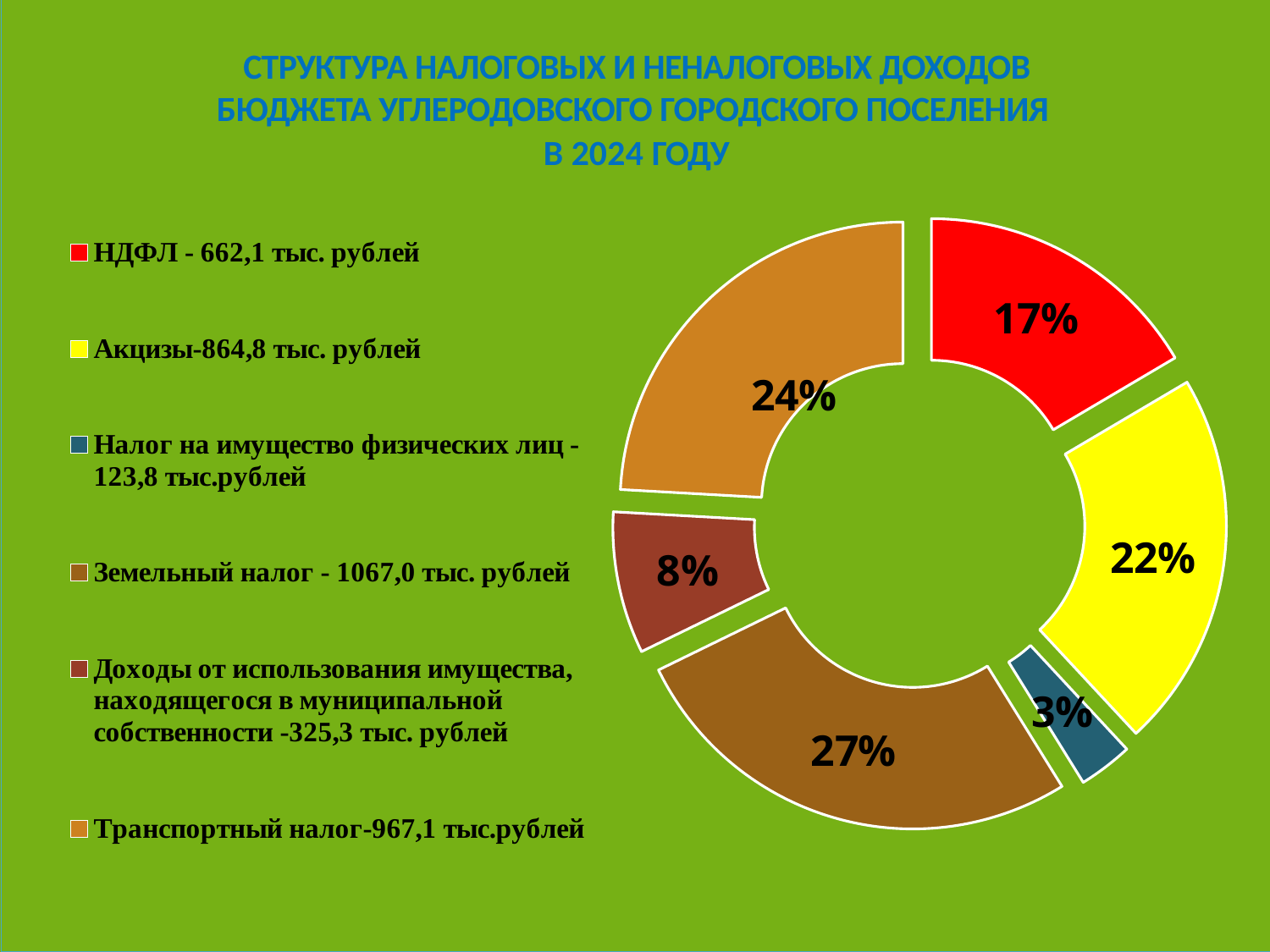
Which category has the smallest share of the chart? Налог на имущество физических лиц According to the legend, what is the value for Земельный налог? 1067,0 тыс. рублей What kind of chart is shown on the slide? Doughnut (pie) chart How many categories does the chart show? 6 What share of the chart does НДФЛ account for? 17% What share of the chart does Акцизы account for? 22% What share of the chart does Земельный налог account for? 27% What colour represents Акцизы in the chart? Yellow Which has a larger share: Акцизы or Транспортный налог? Транспортный налог What is the difference in percentage points between the share of Земельный налог and the share of НДФЛ? 10 percentage points Which category has the largest share of the chart? Земельный налог